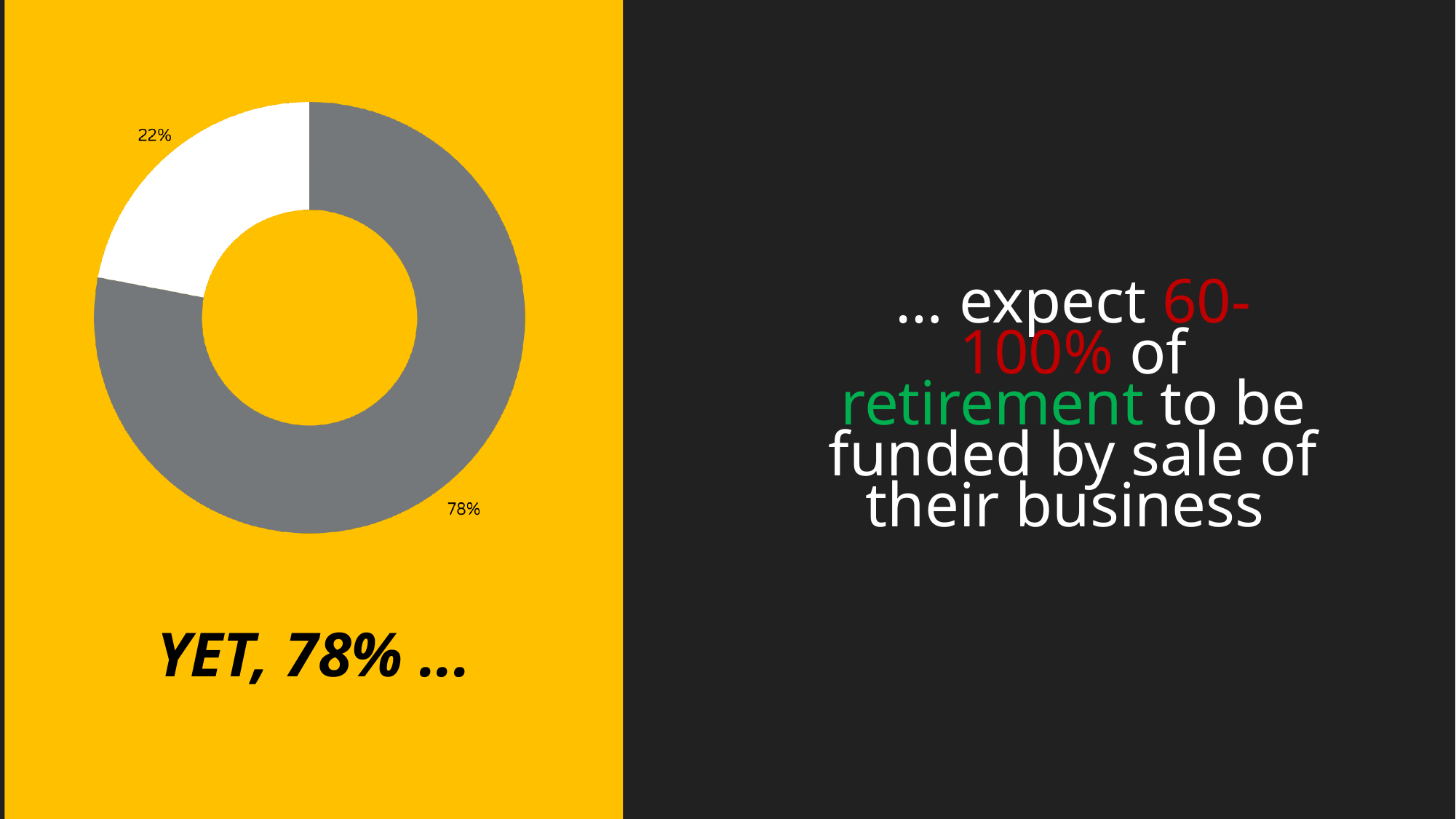
What is the smallest value shown on the doughnut chart? 22% What value is labelled on the grey segment of the doughnut chart? 78% What is the largest value shown on the doughnut chart? 78% How many segments does the doughnut chart have? 2 What text appears in bold italics below the doughnut chart? YET, 78% ... What do the two segments of the doughnut chart add up to? 100% What is the difference between the two values shown on the doughnut chart? 56% What colour is the segment labelled 78%? Grey What value is labelled on the white segment of the doughnut chart? 22% What kind of chart is shown on the slide? Doughnut chart Which segment of the doughnut chart is larger, the grey one or the white one? The grey one